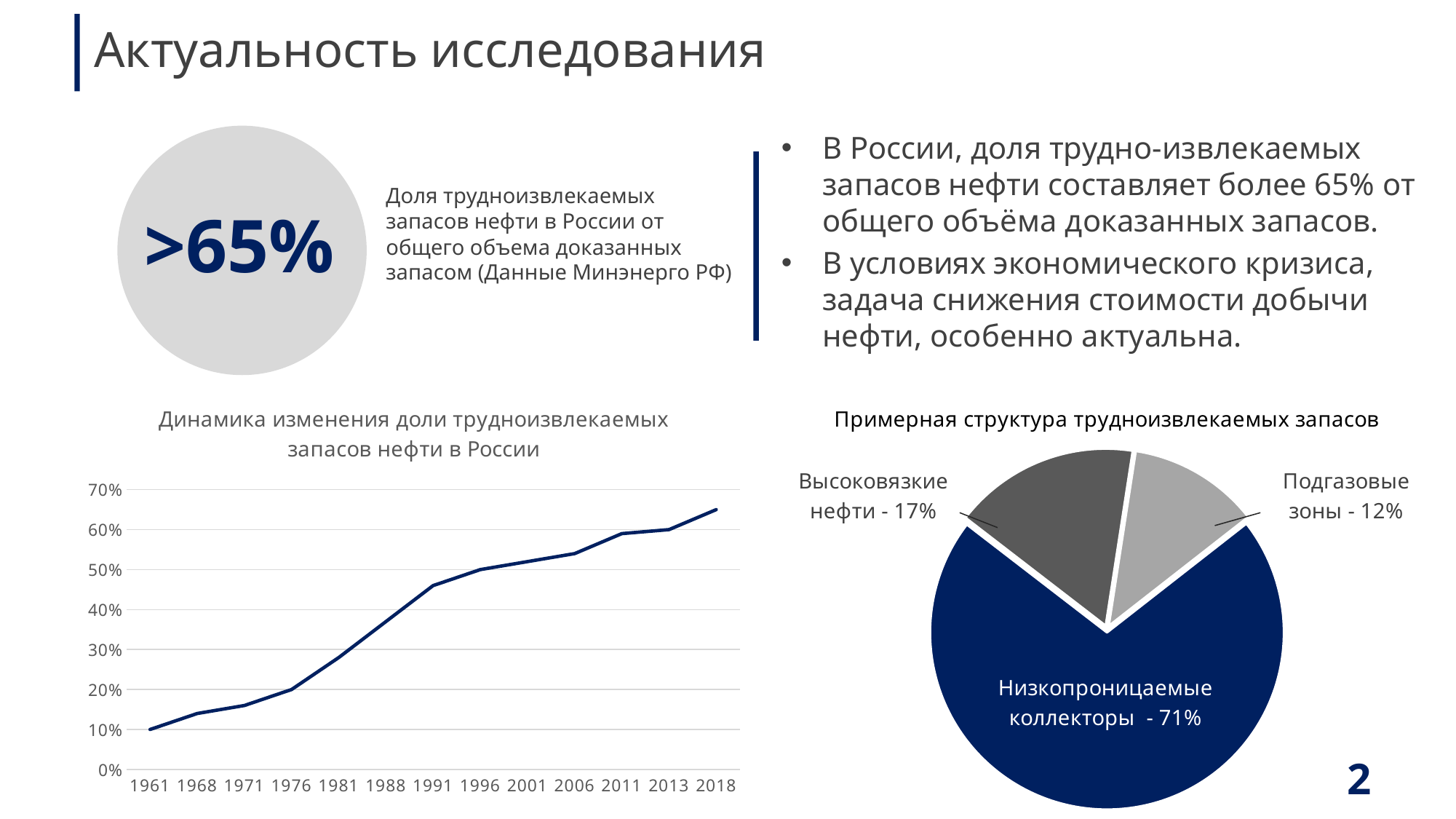
In the pie chart 'Примерная структура трудноизвлекаемых запасов', by how many percentage points does Высоковязкие нефти exceed Подгазовые зоны? 5 percentage points In the pie chart 'Примерная структура трудноизвлекаемых запасов', what share is shown for Низкопроницаемые коллекторы? 71% In the pie chart 'Примерная структура трудноизвлекаемых запасов', which category has the largest share? Низкопроницаемые коллекторы In the pie chart 'Примерная структура трудноизвлекаемых запасов', what share is shown for Подгазовые зоны? 12% What kind of chart is 'Динамика изменения доли трудноизвлекаемых запасов нефти в России'? Line chart How many years are shown on the x axis of the chart 'Динамика изменения доли трудноизвлекаемых запасов нефти в России'? 13 How many slices does the pie chart 'Примерная структура трудноизвлекаемых запасов' have? 3 In the chart 'Динамика изменения доли трудноизвлекаемых запасов нефти в России', do the values rise or fall from 1961 to 2018? Rise In the chart 'Динамика изменения доли трудноизвлекаемых запасов нефти в России', is the value for 2018 greater or less than 60%? greater What kind of chart is 'Примерная структура трудноизвлекаемых запасов'? Pie chart In the pie chart 'Примерная структура трудноизвлекаемых запасов', which category has the smallest share? Подгазовые зоны In the pie chart 'Примерная структура трудноизвлекаемых запасов', what share is shown for Высоковязкие нефти? 17%